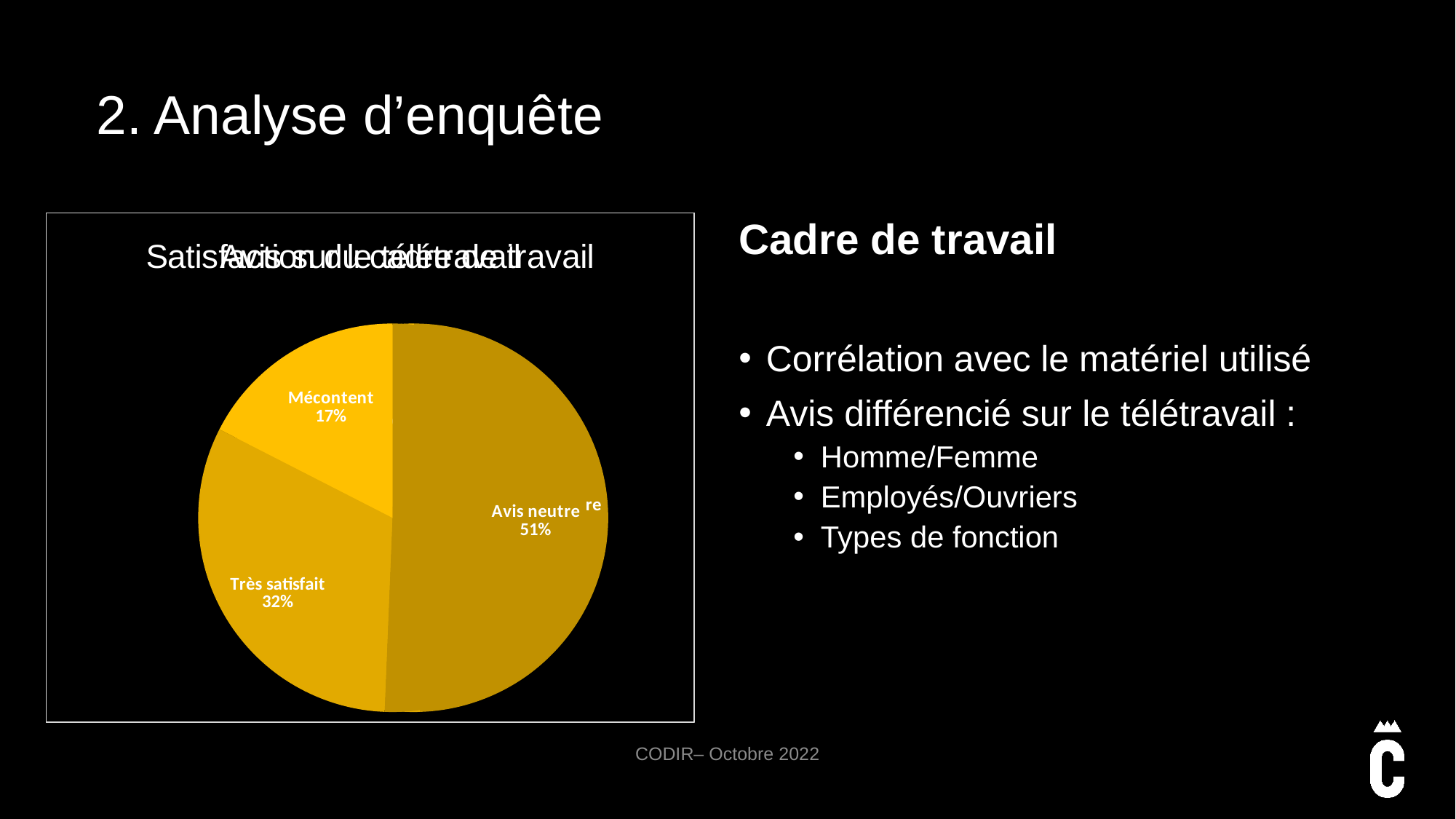
Which slice of the pie chart is the largest? Avis neutre How many slices does the pie chart have? 3 What kind of chart is shown on the slide? pie chart What percentage of the pie chart is labelled "Très satisfait"? 32% Which slice of the pie chart is the smallest? Mécontent Is the "Avis neutre" slice more or less than half of the pie chart? more What is the difference in percentage points between the "Avis neutre" slice and the "Très satisfait" slice? 19 What percentage of the pie chart is labelled "Mécontent"? 17% Which is larger in the pie chart, "Très satisfait" or "Mécontent"? Très satisfait What percentage of the pie chart is labelled "Avis neutre"? 51% What is the difference in percentage points between the "Très satisfait" slice and the "Mécontent" slice? 15 Are the data labels in the pie chart placed inside or outside the slices? inside